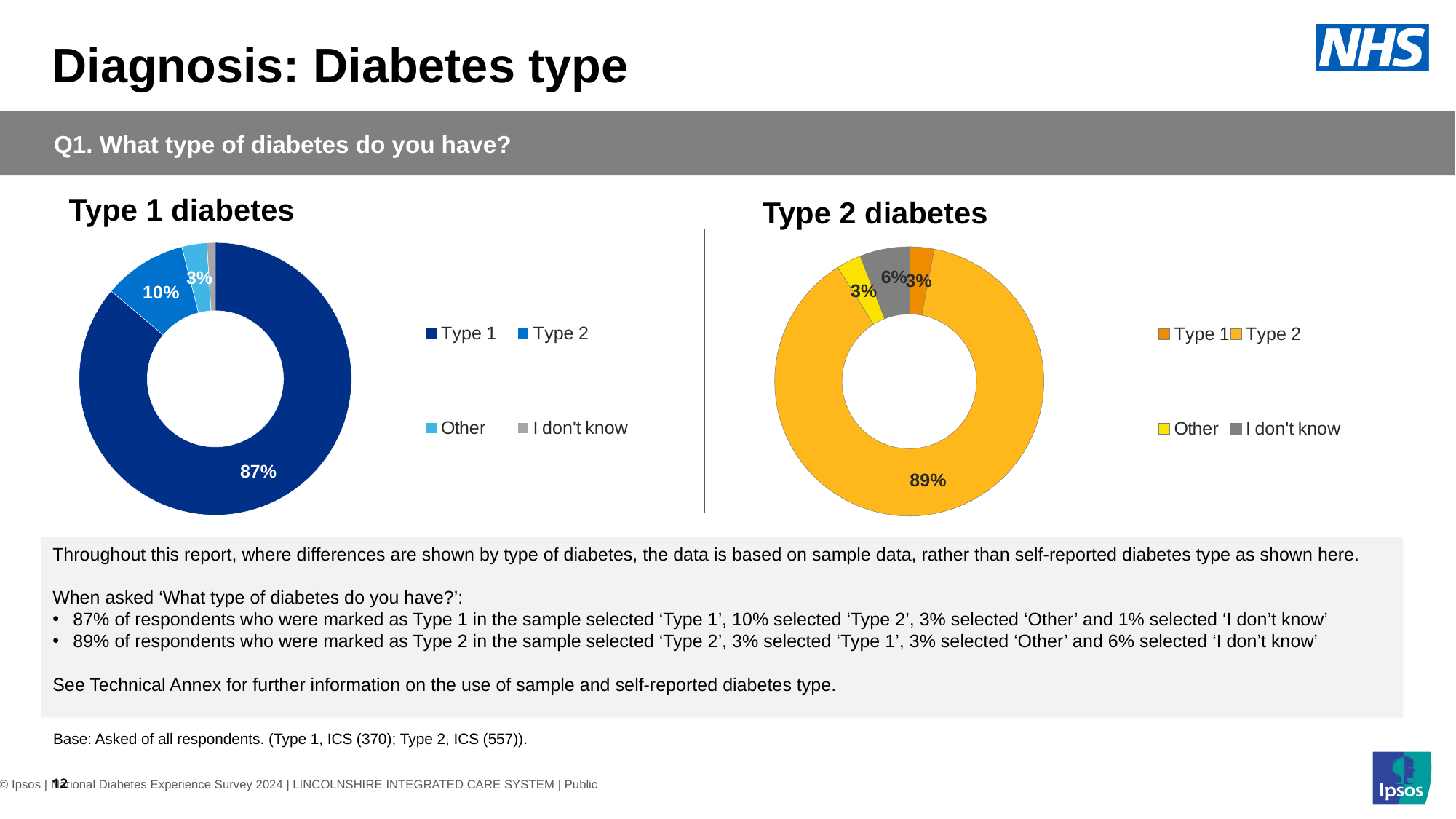
In the 'Type 1 diabetes' chart, what percentage selected 'Type 2'? 10% In the 'Type 2 diabetes' chart, what percentage selected 'I don't know'? 6% In the 'Type 1 diabetes' chart, what percentage selected 'Other'? 3% In the 'Type 2 diabetes' chart, what colour is the 'Other' segment? Yellow How many categories does the legend of the 'Type 2 diabetes' chart list? 4 In the 'Type 1 diabetes' chart, what is the difference between the 'Type 1' and 'Type 2' shares? 77% In the 'Type 2 diabetes' chart, which category has the largest share? Type 2 In the 'Type 2 diabetes' chart, which is larger: the share for 'I don't know' or the share for 'Other'? I don't know In the 'Type 1 diabetes' chart, which category has the smallest share? I don't know In the 'Type 2 diabetes' chart, what percentage selected 'Type 2'? 89% What kind of chart is the 'Type 1 diabetes' chart? Doughnut (pie) chart In the 'Type 1 diabetes' chart, what percentage selected 'Type 1'? 87%